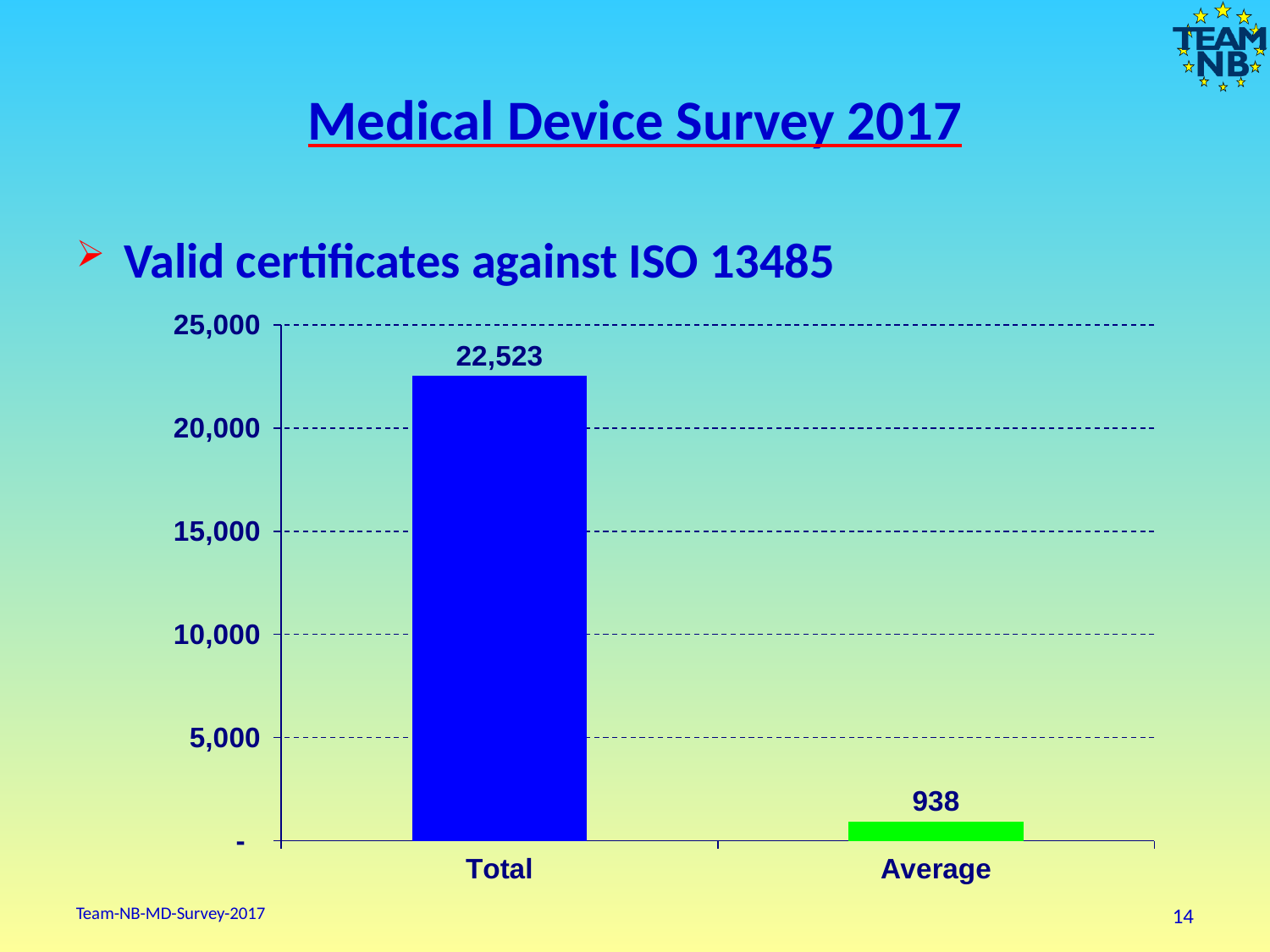
Which category has the highest value? Total Is the value for Average greater or less than 5,000? less What is the value of the Average bar? 938 Which is larger, the Total value or the Average value? Total Which category has the lowest value? Average What colour is the Average bar? green What is the highest value shown on the y axis? 25,000 What is the difference between the Total and Average values? 21,585 How many categories are shown on the x axis? 2 What kind of chart is shown on the slide? bar chart Is the value for Total greater or less than 20,000? greater What is the value of the Total bar? 22,523